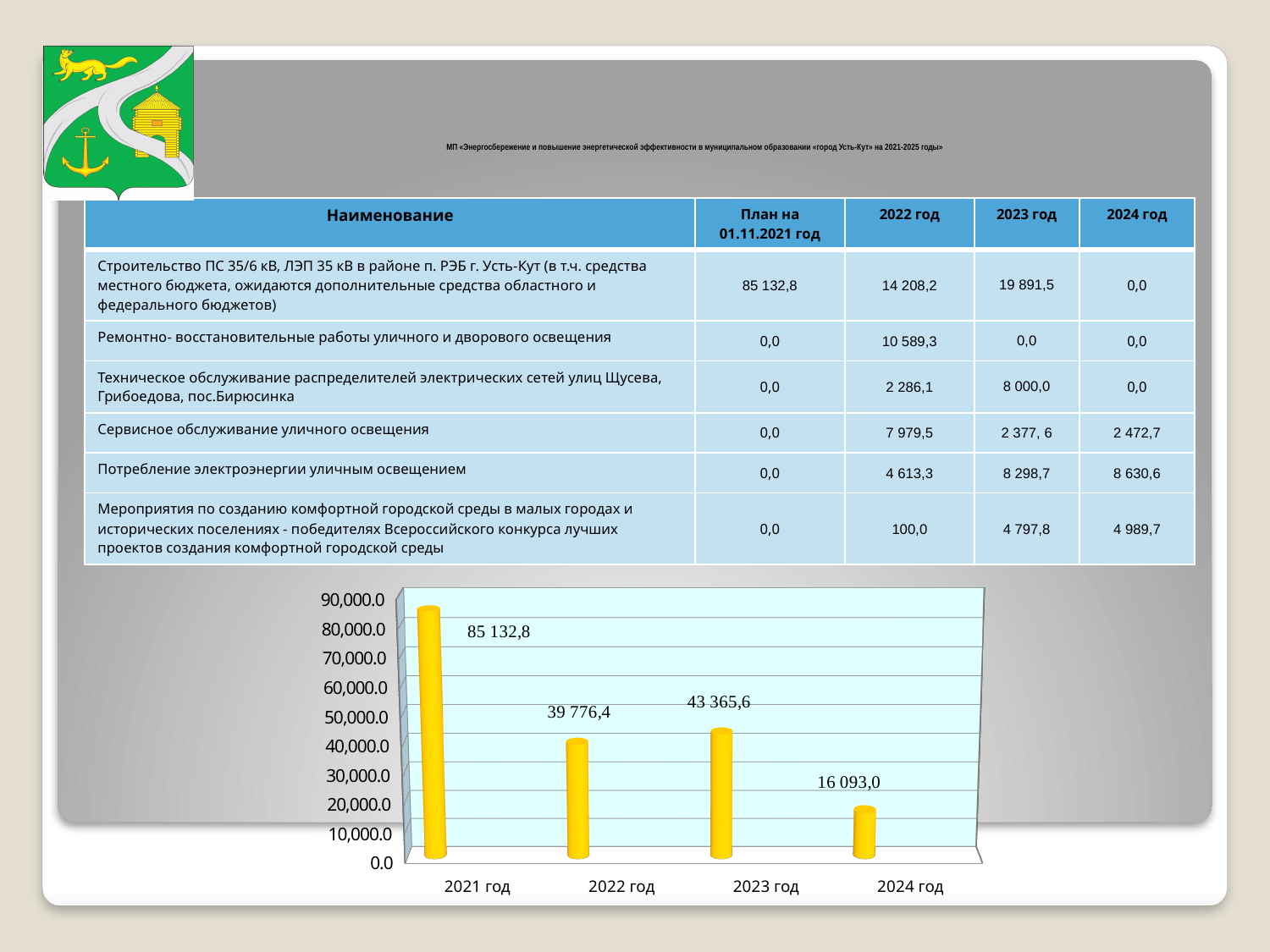
What is the value for 2021 год? 85 132,8 What is the difference between the values for 2023 год and 2022 год? 3 589,2 Which year has the highest value? 2021 год What is the value for 2022 год? 39 776,4 Which year has the lowest value? 2024 год Is the value for 2024 год greater or less than 20,000.0? less How many years are shown on the x axis of the chart? 4 What is the value for 2023 год? 43 365,6 What is the value for 2024 год? 16 093,0 What is the difference between the values for 2021 год and 2024 год? 69 039,8 Which is larger, the value for 2022 год or 2023 год? 2023 год What kind of chart is shown on the slide? bar chart